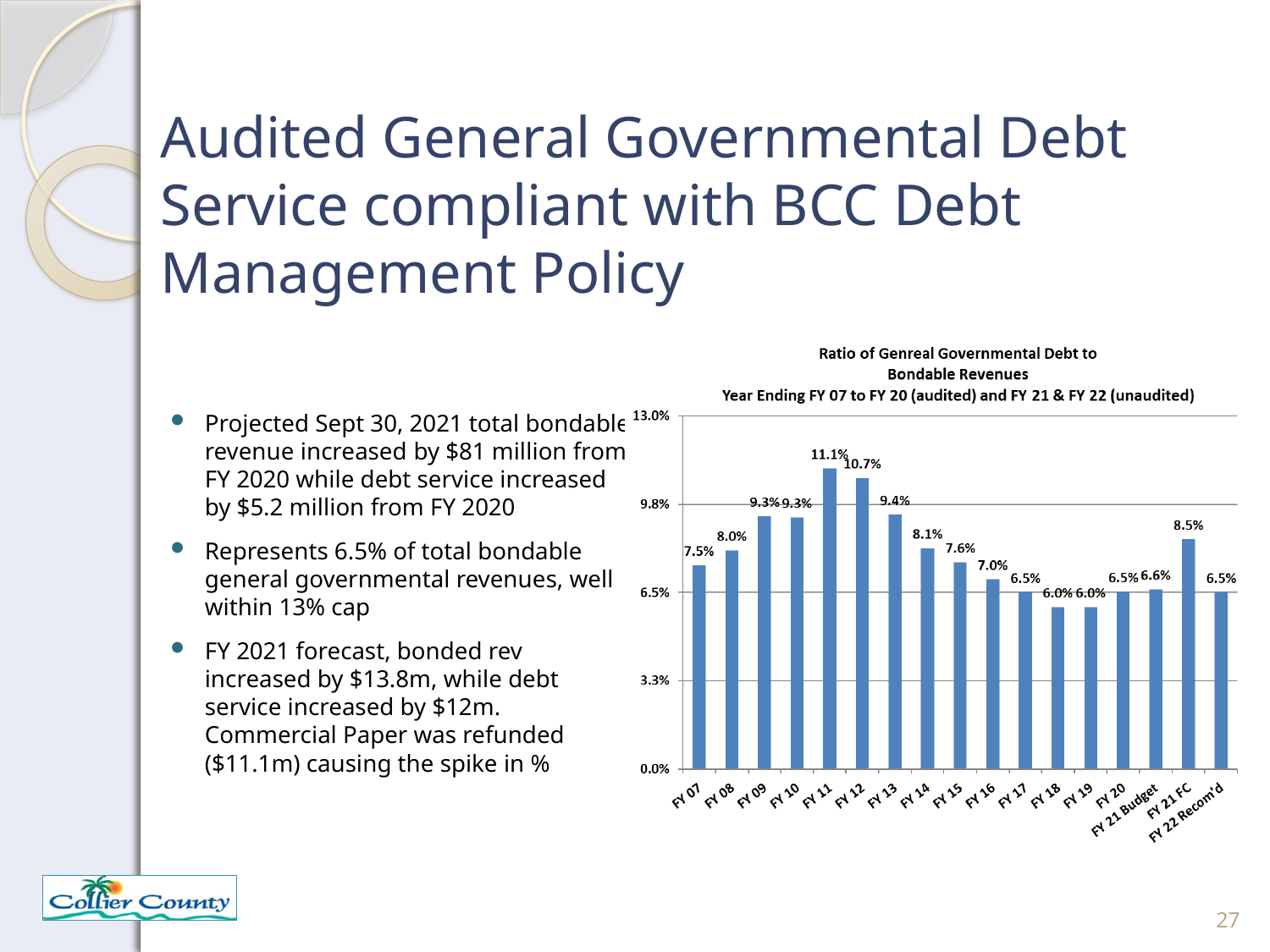
Which is larger, the value for FY 13 or the value for FY 14? FY 13 What is the ratio value shown for FY 21 FC? 8.5% What is the ratio value shown for FY 22 Recom'd? 6.5% Do the values rise or fall from FY 11 through FY 19? Fall What is the ratio value shown for FY 16? 7.0% What is the difference between the FY 21 FC value and the FY 21 Budget value? 1.9 percentage points What is the lowest ratio value shown in the chart? 6.0% Which fiscal year has the highest ratio in the chart? FY 11 What is the difference between the FY 11 value and the FY 12 value? 0.4 percentage points What type of chart is shown on the slide? Bar chart What is the ratio value shown for FY 11? 11.1% How many fiscal year categories are shown on the x axis of the chart? 17